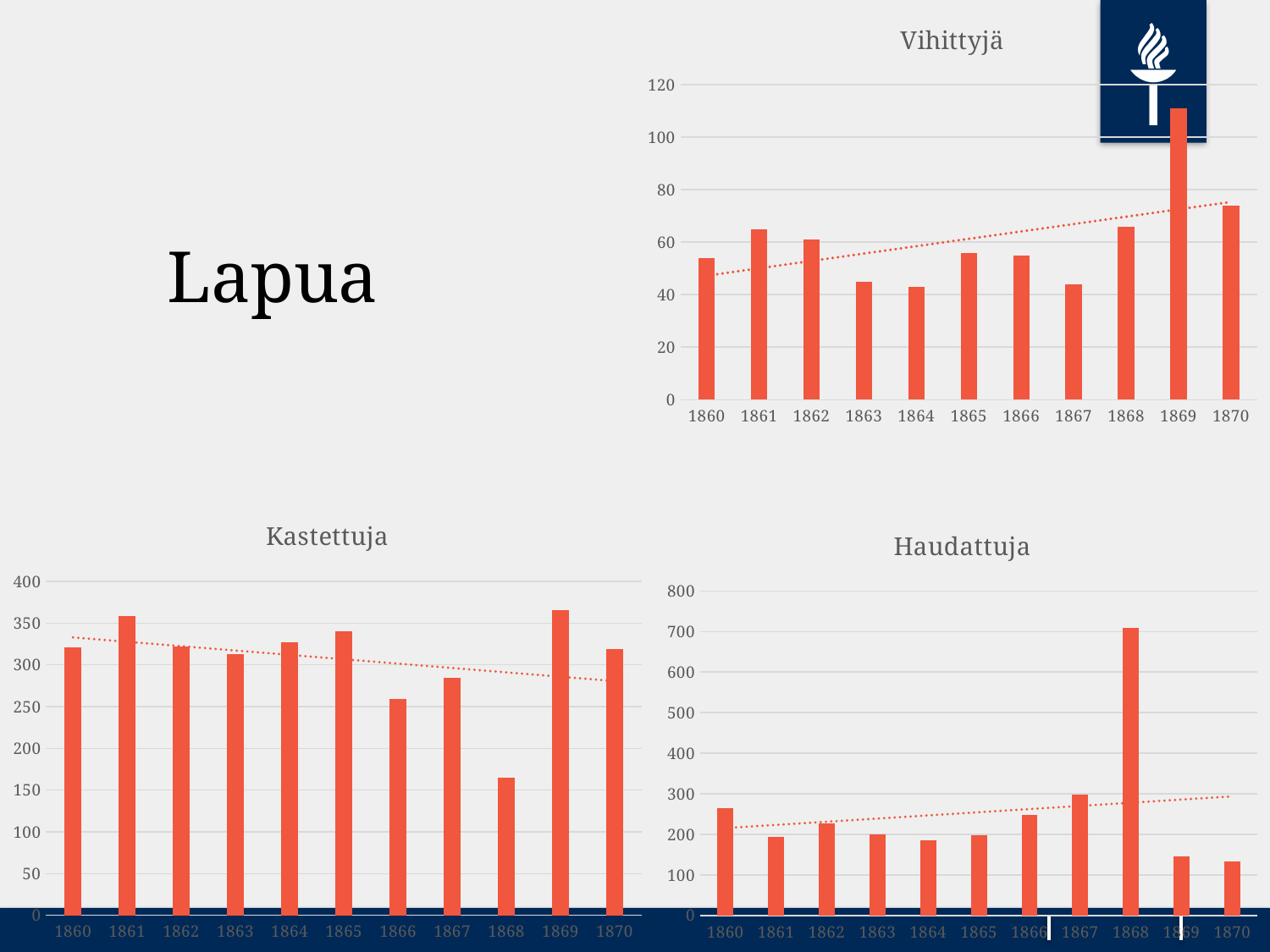
In the Kastettuja chart, does the dotted trend line rise or fall from 1860 to 1870? falls In the Haudattuja chart, is the value for 1868 greater or less than 600? greater In the Kastettuja chart, is the value for 1868 greater or less than 200? less In the Haudattuja chart, which year has the highest value? 1868 In the Vihittyjä chart, which year has the highest value? 1869 How many years are shown on the x axis of the Kastettuja chart? 11 In the Kastettuja chart, which is larger, the value for 1866 or the value for 1868? 1866 What kind of chart is the Haudattuja chart? bar chart In the Vihittyjä chart, does the dotted trend line rise or fall from 1860 to 1870? rises In the Kastettuja chart, which year has the lowest value? 1868 In the Vihittyjä chart, is the value for 1860 greater or less than 60? less